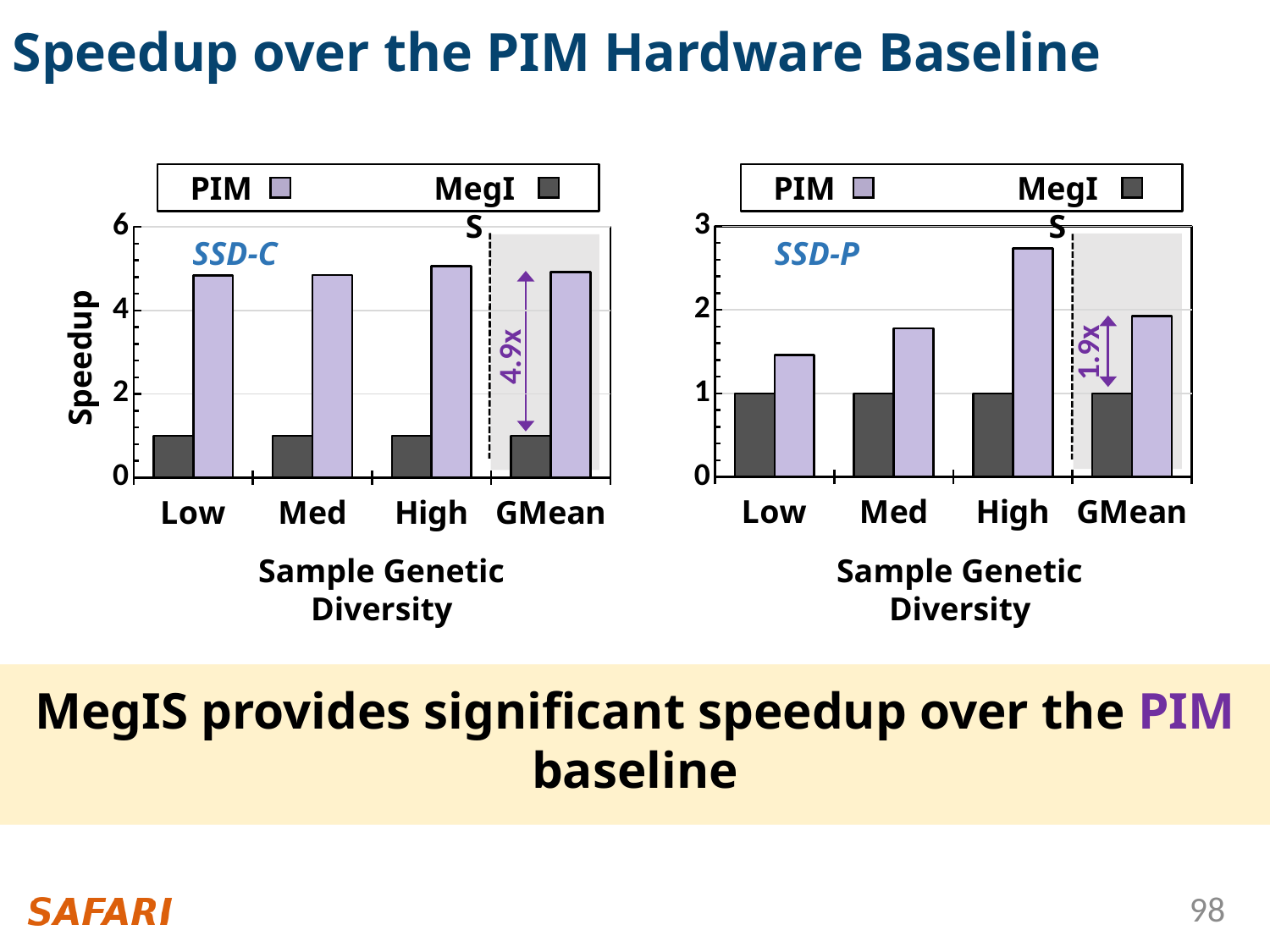
In the SSD-P chart, which category has the shortest light purple bar? Low What is the x-axis title of the SSD-P chart? Sample Genetic Diversity How many series does the legend of the SSD-P chart list? 2 How many categories are shown on the x axis of the SSD-C chart? 4 In the SSD-P chart, is the light purple bar for Med taller or shorter than the one for High? shorter In the SSD-P chart, what speedup is annotated at the GMean category? 1.9x In the SSD-P chart, what value does the dark bar for Low reach on the y axis? 1 What kind of chart is the SSD-C chart on the left? bar chart In the SSD-P chart, is the light purple bar for Low greater or less than 2? less In the SSD-C chart, is the light purple bar for Low greater or less than 4? greater In the SSD-C chart, what speedup is annotated at the GMean category? 4.9x In the SSD-P chart, which category has the tallest light purple bar? High